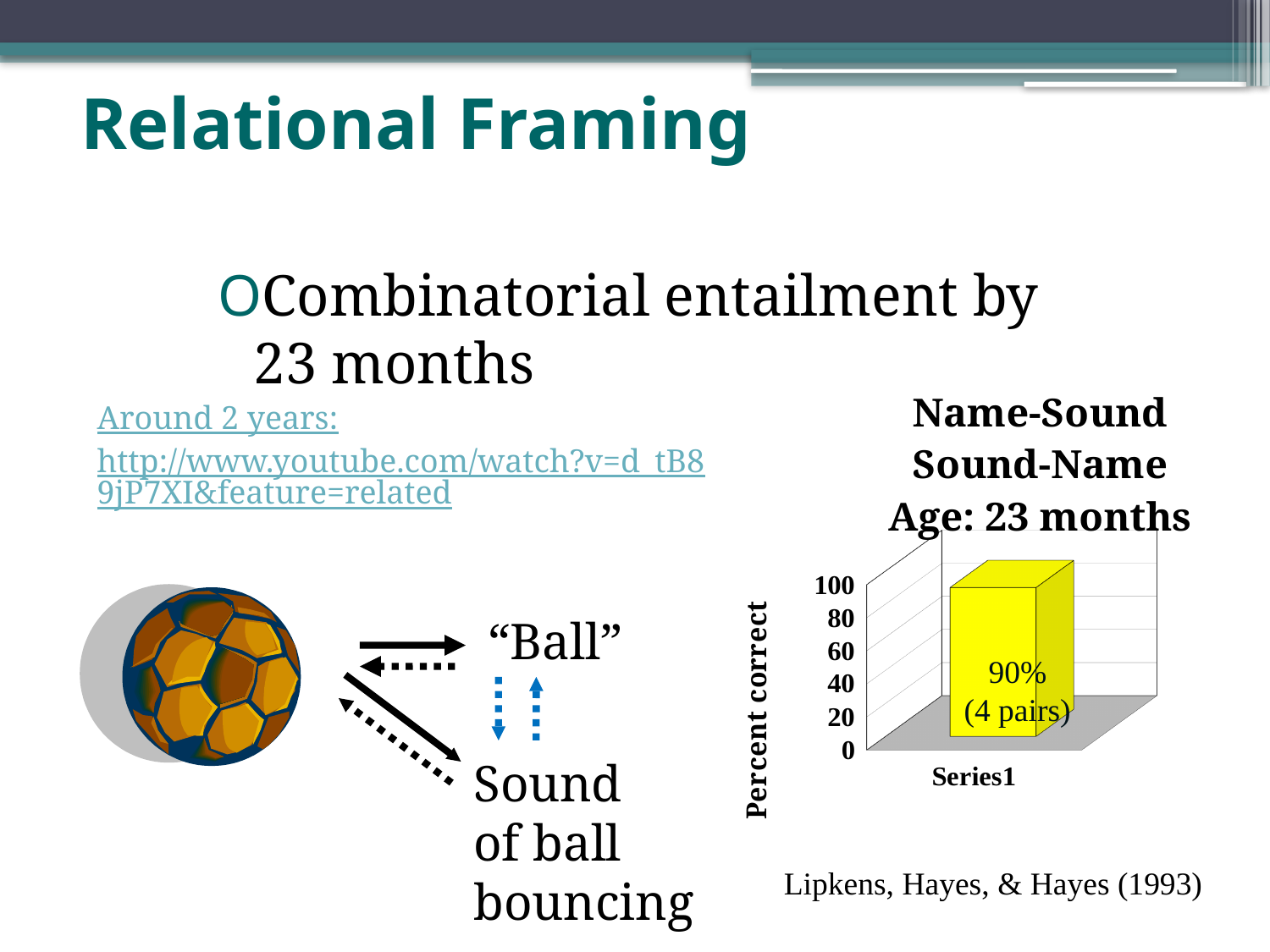
How many bars are plotted in the chart? 1 Is the value of the bar in the chart greater or less than 60? greater What kind of chart is shown on the slide? bar chart Is the value of the bar in the chart greater or less than 80? greater How many pairs does the label on the bar say the result is based on? 4 pairs What age is stated in the chart's title? 23 months What is the category label shown beneath the bar in the chart? Series1 What is the highest tick value shown on the vertical axis of the chart? 100 Is the value of the bar in the chart greater or less than 100? less What is the label on the vertical axis of the chart? Percent correct What percent correct is labelled on the bar in the chart? 90%